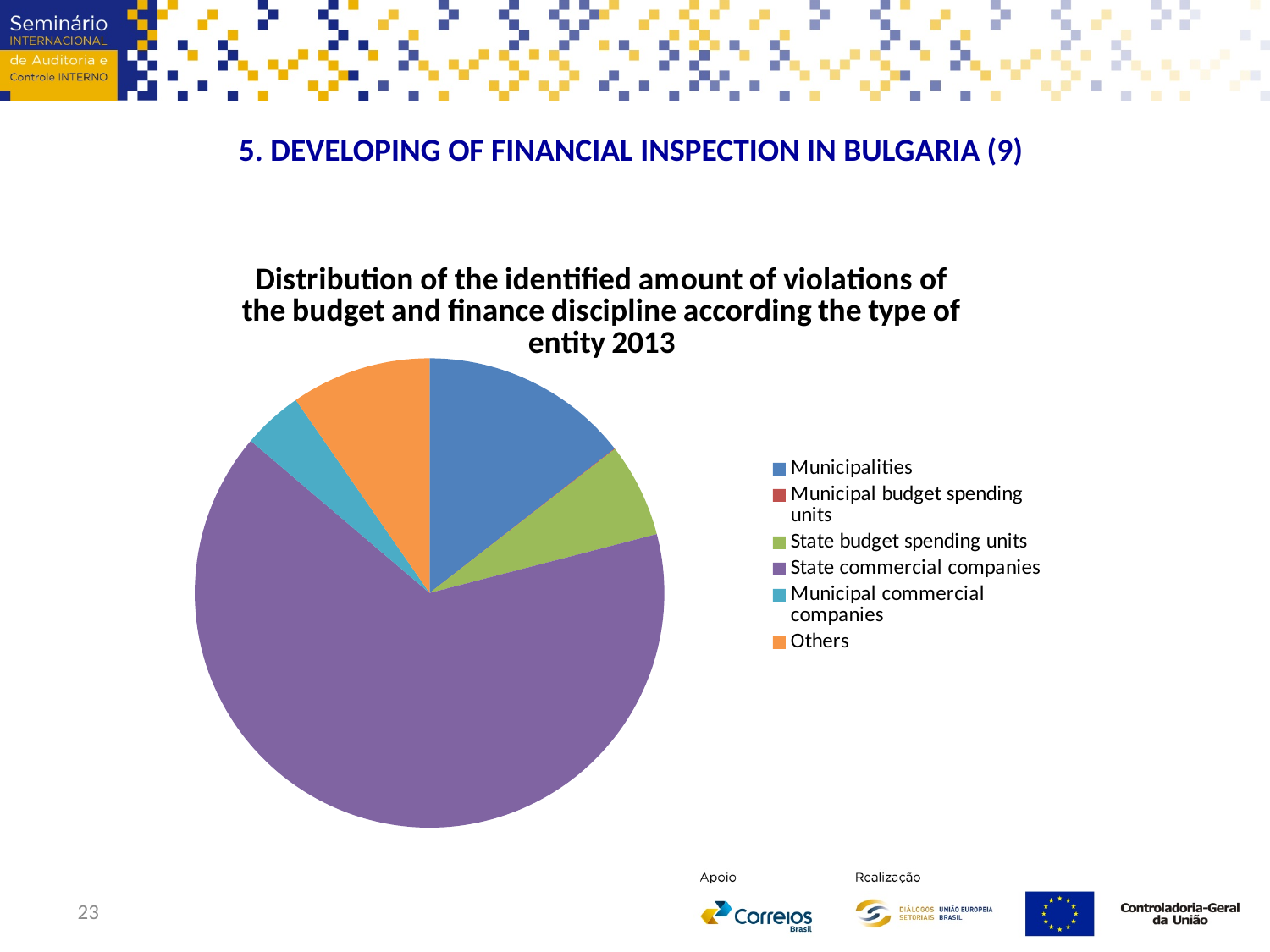
Which slice is larger: State commercial companies or Municipalities? State commercial companies What colour represents State commercial companies in the pie chart? purple What is the title of the chart? Distribution of the identified amount of violations of the budget and finance discipline according the type of entity 2013 Which type of entity has the largest slice of the pie? State commercial companies Which year does the chart refer to? 2013 Which slice is larger: Others or Municipal commercial companies? Others How many entries does the chart legend list? 6 Is the share for State commercial companies greater or less than 50% of the pie? greater Which slice is larger: Municipal commercial companies or State budget spending units? State budget spending units Is the share for Municipalities greater or less than 50% of the pie? less What kind of chart is shown on the slide? pie chart